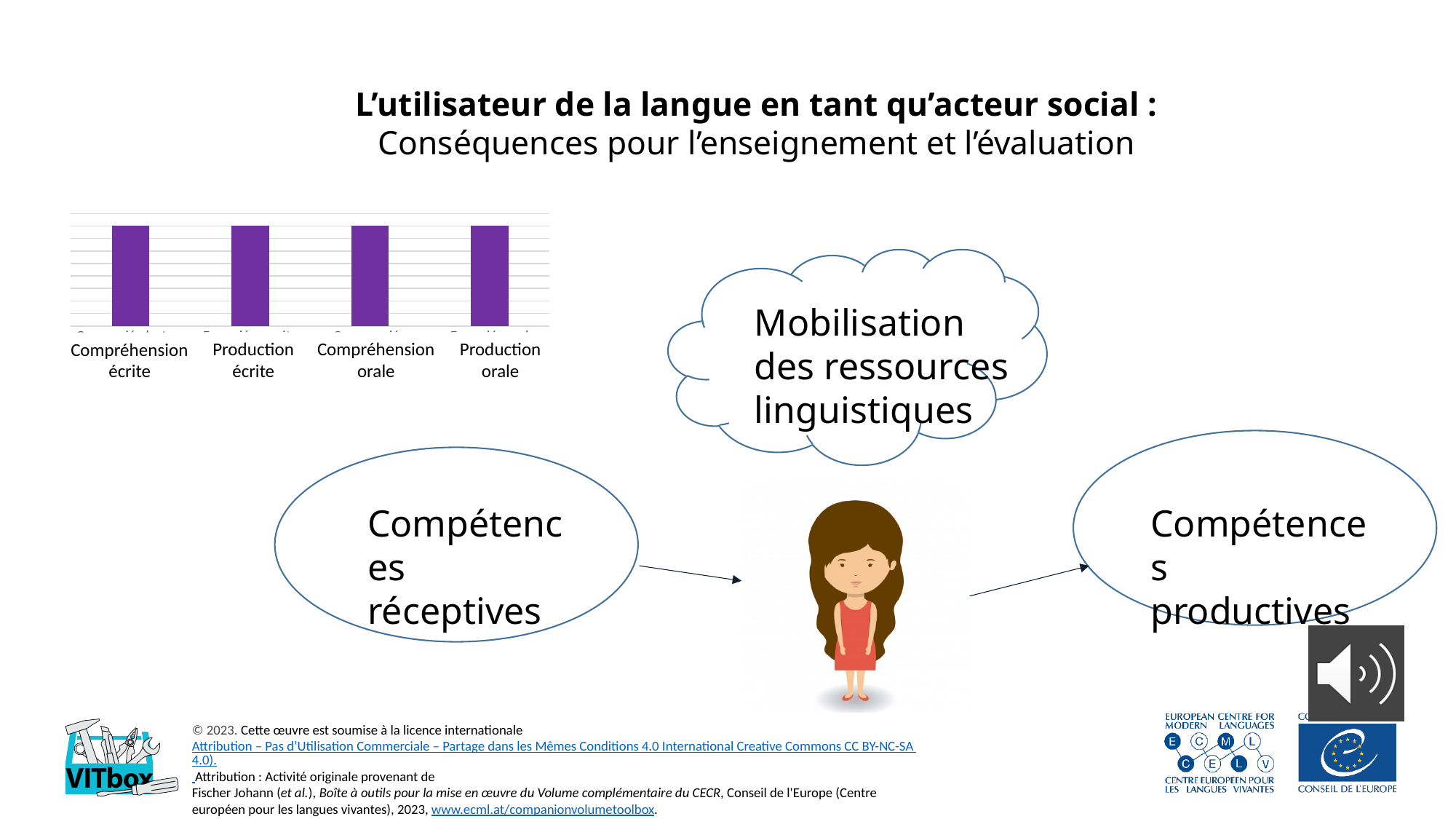
Do the bar heights rise, fall, or stay level from left to right across the chart? stay level What kind of chart is shown on the left of the slide? bar chart What is the label of the first category in the chart? Compréhension écrite What is the label of the last category in the chart? Production orale How many bars does the chart on the left of the slide have? 4